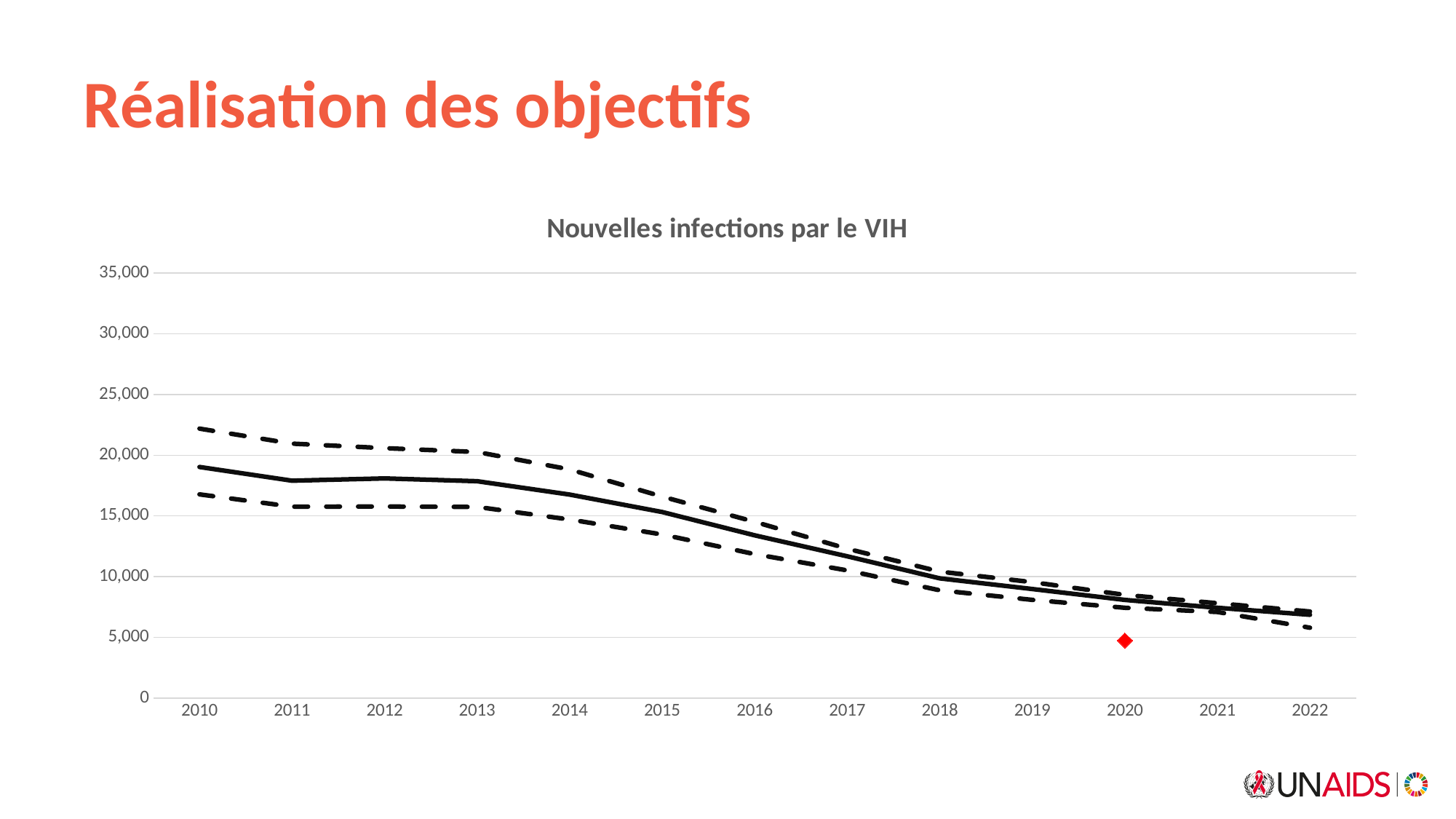
In which year is the solid line at its lowest value? 2022 Is the value of the solid line in 2010 greater or less than 15,000? greater What is the title of the chart? Nouvelles infections par le VIH How many years are shown along the x axis of the chart? 13 Is the value of the solid line in 2010 greater or less than 20,000? less Is the value of the solid line in 2016 greater or less than 15,000? less What kind of chart is shown on the slide? line chart In which year is the red diamond marker plotted? 2020 Which year has the larger value on the solid line, 2013 or 2019? 2013 Does the solid line rise or fall from 2010 to 2022? fall In which year is the solid line at its highest value? 2010